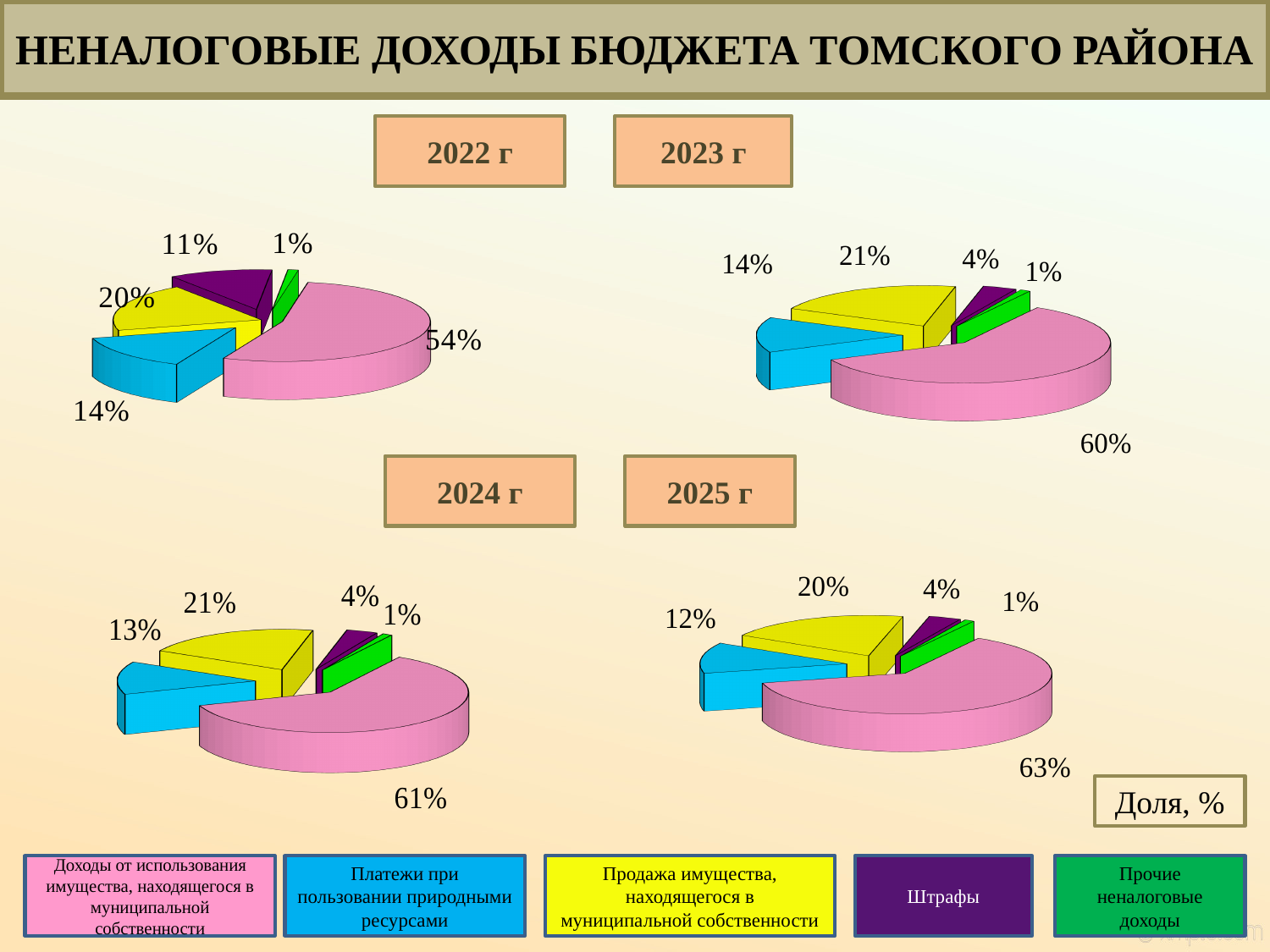
In the 2024 г pie chart, which is larger: the share for Платежи при пользовании природными ресурсами or the share for Продажа имущества, находящегося в муниципальной собственности? Продажа имущества, находящегося в муниципальной собственности What type of chart is used for each year on the slide? Pie chart In the 2025 г pie chart, what share is shown for Платежи при пользовании природными ресурсами (blue slice)? 12% In the 2022 г pie chart, what share is shown for Штрафы (purple slice)? 11% How many slices does each pie chart on the slide have? 5 In the 2023 г pie chart, which category has the smallest share? Прочие неналоговые доходы In the 2023 г pie chart, what share is shown for Продажа имущества, находящегося в муниципальной собственности (yellow slice)? 21% What is the difference between the share of Доходы от использования имущества in the 2025 г chart and in the 2022 г chart? 9 percentage points Which colour represents Штрафы in the legend? Purple In the 2024 г pie chart, which category has the largest share? Доходы от использования имущества, находящегося в муниципальной собственности Does the share of Доходы от использования имущества rise or fall from 2022 г to 2025 г across the four charts? Rise In the 2022 г pie chart, what share is shown for Доходы от использования имущества, находящегося в муниципальной собственности (pink slice)? 54%